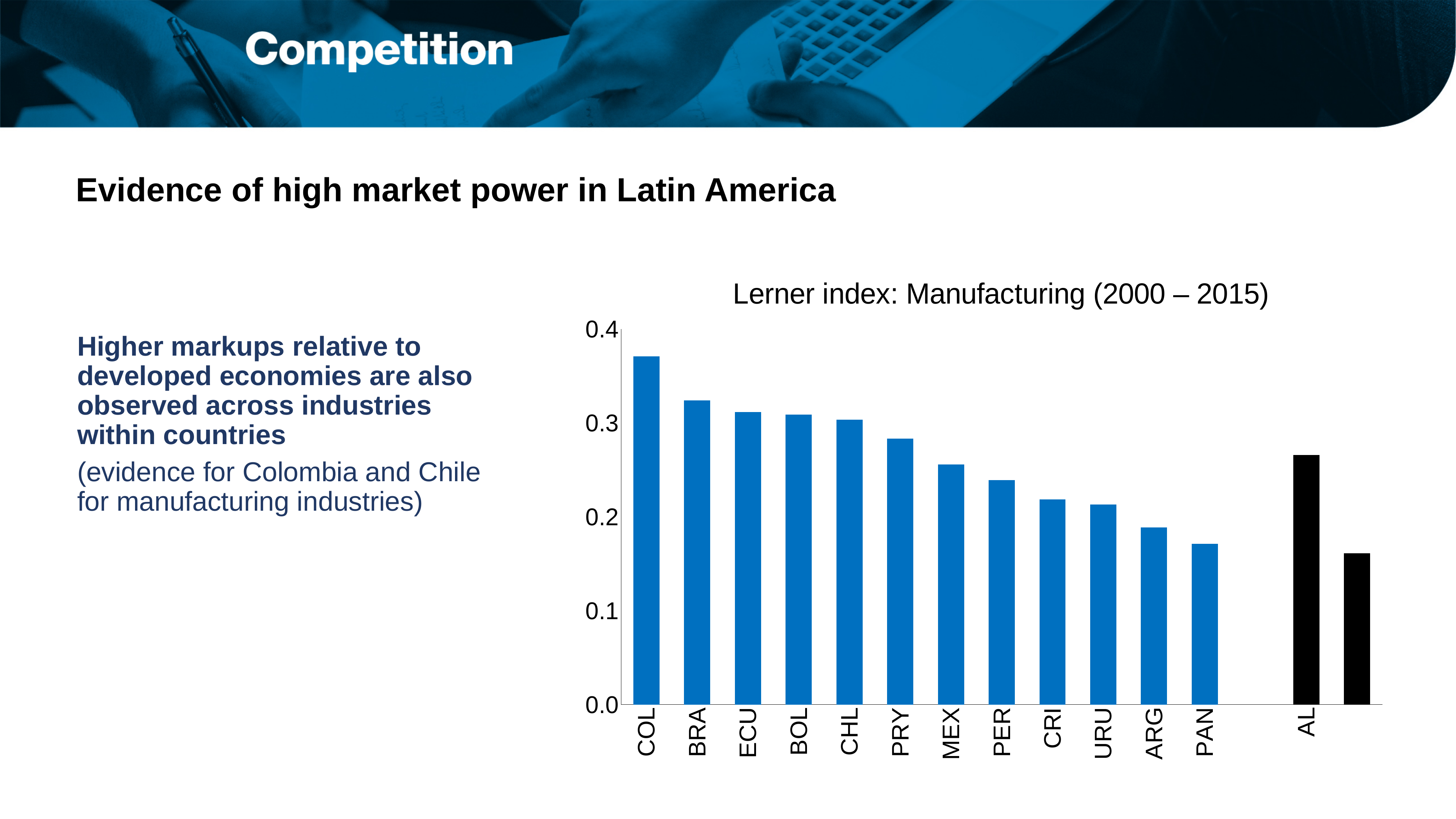
Which country has the highest Lerner index in the chart? COL Is the value for AL greater or less than 0.2? greater Is the value for MEX greater or less than 0.3? less Is the value for PAN greater or less than 0.2? less What is the title of the chart? Lerner index: Manufacturing (2000 – 2015) What kind of chart is shown on the slide? Bar chart What colour is the bar for AL? Black Which has a higher Lerner index, AL or PAN? AL Which has a higher Lerner index, COL or BRA? COL Do the values rise or fall moving from COL to PAN along the x axis? fall